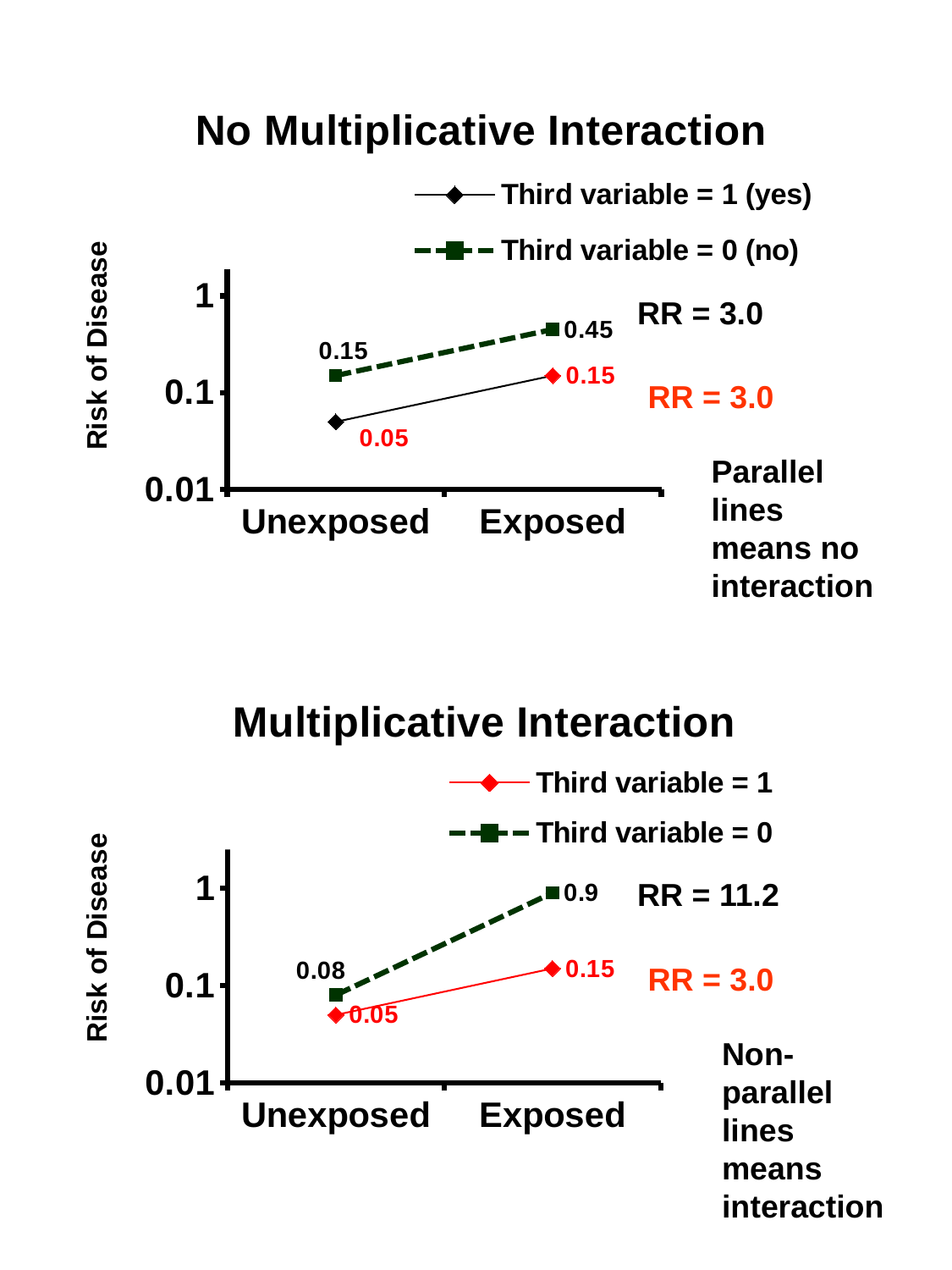
In the 'Multiplicative Interaction' chart, what is the risk of disease for the Exposed group when Third variable = 0? 0.9 In the 'No Multiplicative Interaction' chart, what is the difference in risk of disease between the Exposed and Unexposed groups for Third variable = 0 (no)? 0.3 In the 'Multiplicative Interaction' chart, does the risk of disease for Third variable = 0 rise or fall from Unexposed to Exposed? Rise In the 'Multiplicative Interaction' chart, what is the difference in risk of disease between the Exposed and Unexposed groups for Third variable = 1? 0.1 In the 'Multiplicative Interaction' chart, which data point has the lowest risk of disease? Unexposed, Third variable = 1 In the 'No Multiplicative Interaction' chart, what is the risk of disease for the Unexposed group when Third variable = 1 (yes)? 0.05 How many series does the legend of the 'No Multiplicative Interaction' chart list? 2 In the 'Multiplicative Interaction' chart, which series has the higher risk of disease for the Exposed group? Third variable = 0 In the 'No Multiplicative Interaction' chart, which data point has the highest risk of disease? Exposed, Third variable = 0 (no) What kind of chart is the 'Multiplicative Interaction' chart? Line chart In the 'No Multiplicative Interaction' chart, what is the risk of disease for the Exposed group when Third variable = 0 (no)? 0.45 In the 'Multiplicative Interaction' chart, what is the risk of disease for the Unexposed group when Third variable = 0? 0.08